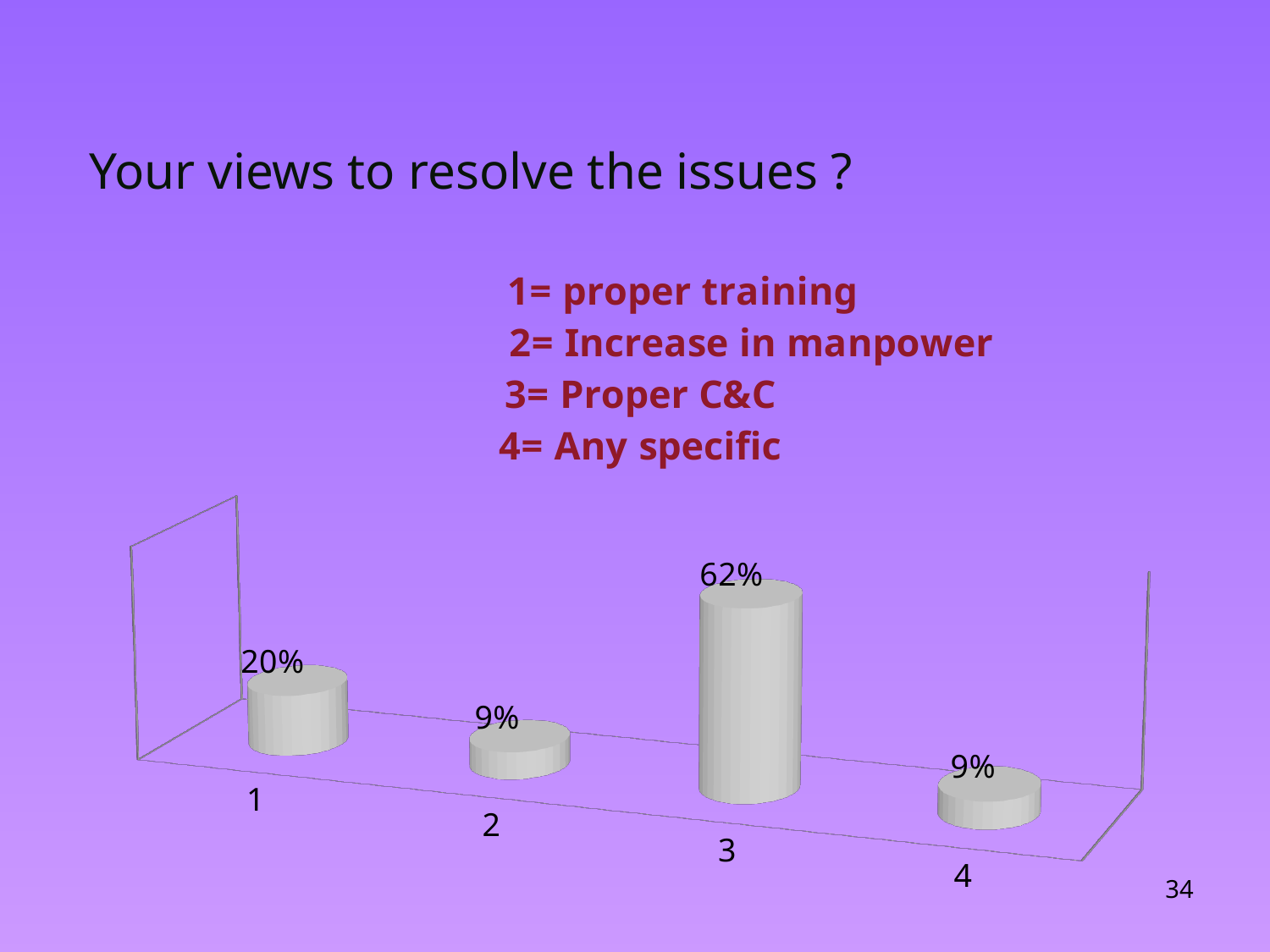
What is the value for category 4 (Any specific)? 9% What is the difference between the values for category 3 and category 1? 42% What is the value for category 1 (proper training)? 20% According to the key on the slide, what does category 3 stand for? Proper C&C What is the total of the values for categories 2 and 4? 18% How many categories are plotted on the chart? 4 Which category has the highest value? 3 What kind of chart is shown on the slide? bar chart What is the value for category 3 (Proper C&C)? 62% Which is larger, the value for category 1 or the value for category 4? category 1 What is the difference between the values for category 1 and category 2? 11% What is the value for category 2 (Increase in manpower)? 9%